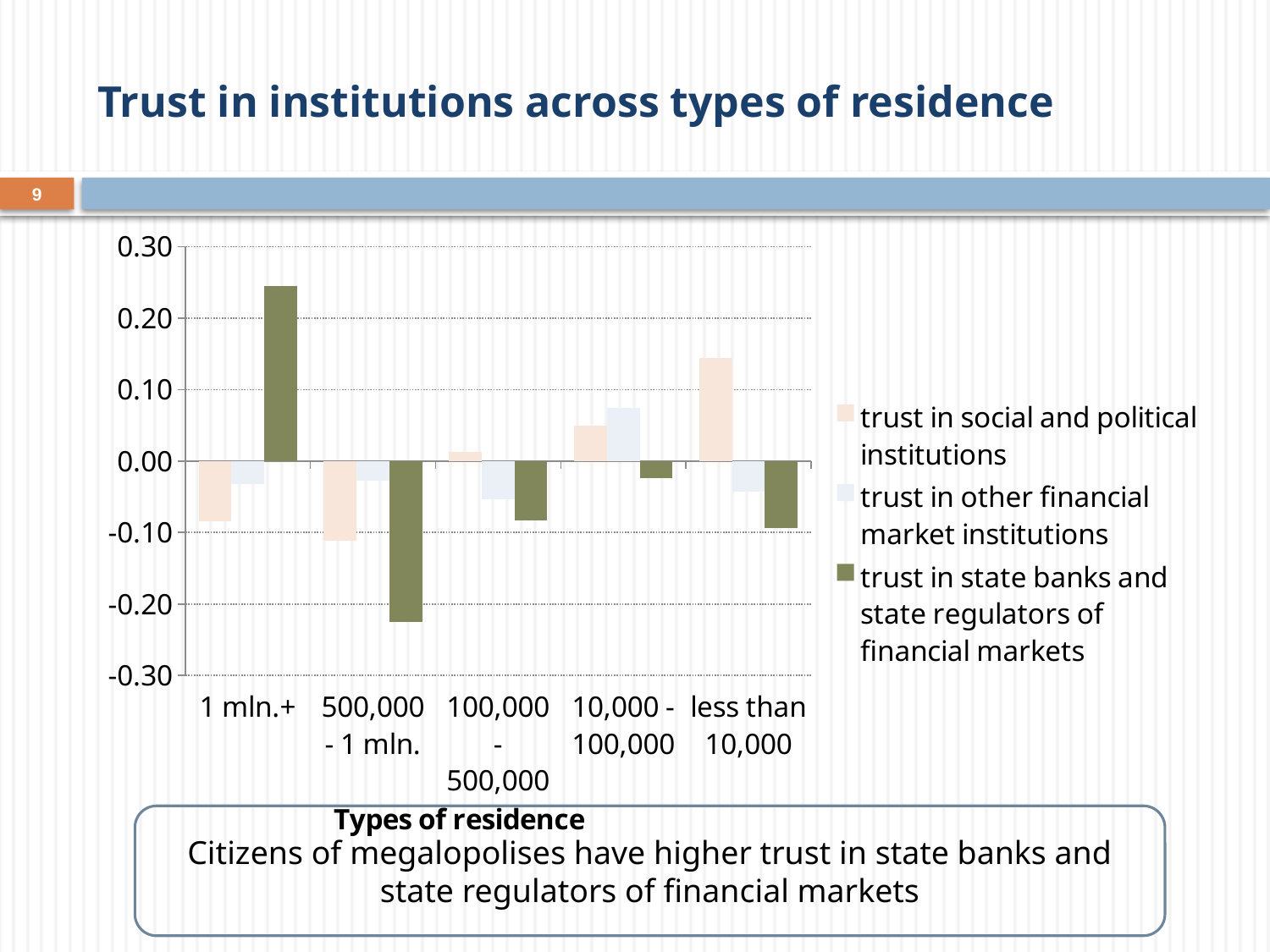
Is the value for trust in state banks and state regulators of financial markets for 1 mln.+ greater or less than 0.20? greater What kind of chart is shown on the slide? bar chart Which type of residence has the highest value for trust in social and political institutions? less than 10,000 Is the value for trust in social and political institutions for less than 10,000 greater or less than 0.10? greater For trust in social and political institutions, which is larger: the value for 1 mln.+ or the value for less than 10,000? less than 10,000 How many types of residence are shown on the x axis of the chart? 5 Which type of residence has the lowest value for trust in state banks and state regulators of financial markets? 500,000 - 1 mln. Is the value for trust in other financial market institutions for 10,000 - 100,000 greater or less than 0.00? greater Which type of residence has the highest value for trust in state banks and state regulators of financial markets? 1 mln.+ How many series does the chart's legend list? 3 What is the title of the x axis of the chart? Types of residence